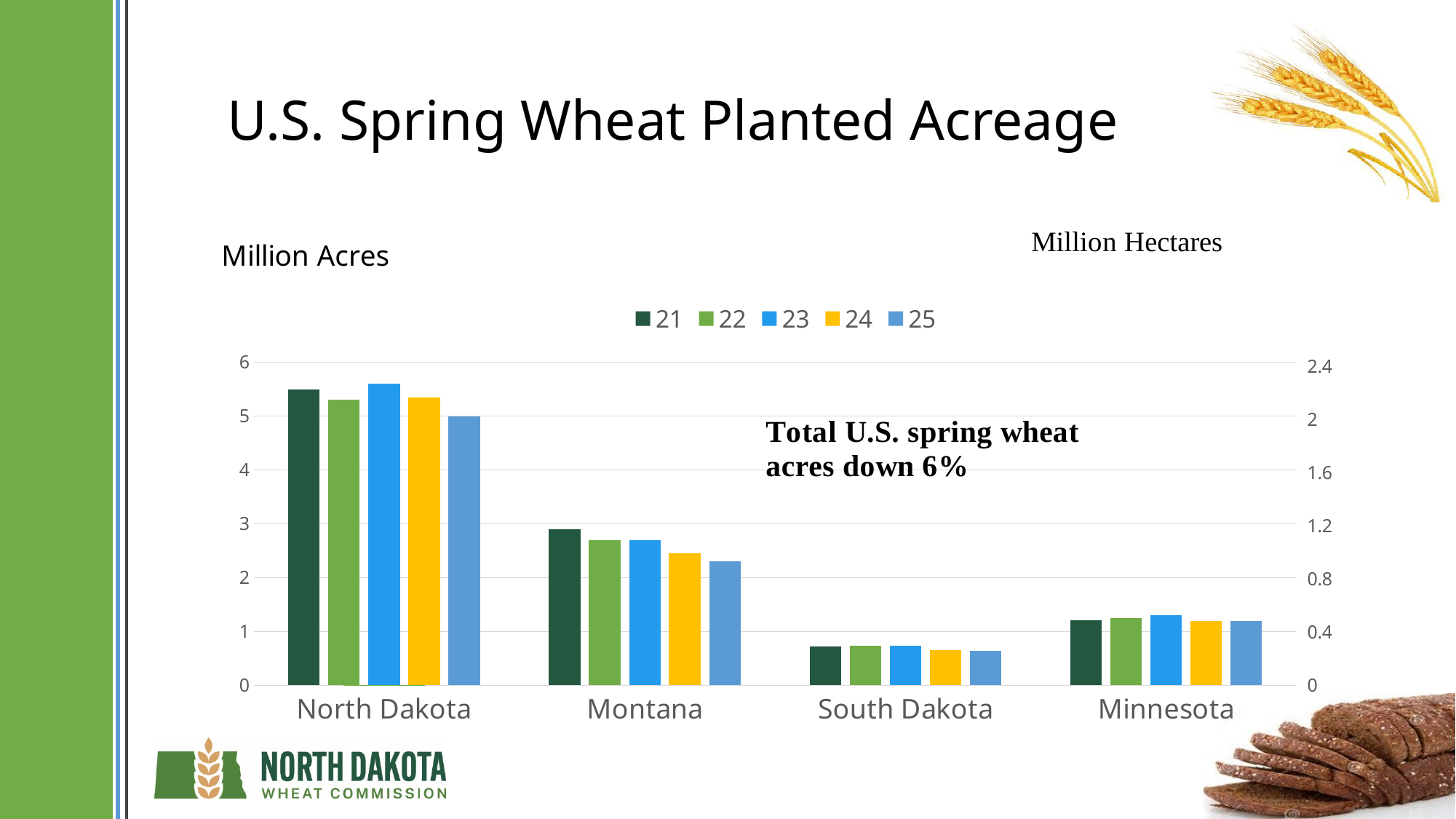
Do Montana's planted acres rise or fall from the 21 series to the 25 series? fall Which state has the lowest spring wheat planted acreage in the 25 series? South Dakota How many states are shown on the x axis of the chart? 4 For North Dakota, which is larger: the 23 series or the 25 series? 23 Which state has the highest spring wheat planted acreage in the 25 series? North Dakota Which is larger in the 21 series: Montana or Minnesota? Montana What is the title of the chart on the slide? Million Acres What kind of chart is shown on the slide? bar chart Is the value for Montana in the 21 series greater or less than 2 million acres? greater Is the value for South Dakota in the 23 series greater or less than 1 million acres? less Is the value for North Dakota in the 25 series greater or less than 4 million acres? greater How many series does the chart's legend list? 5